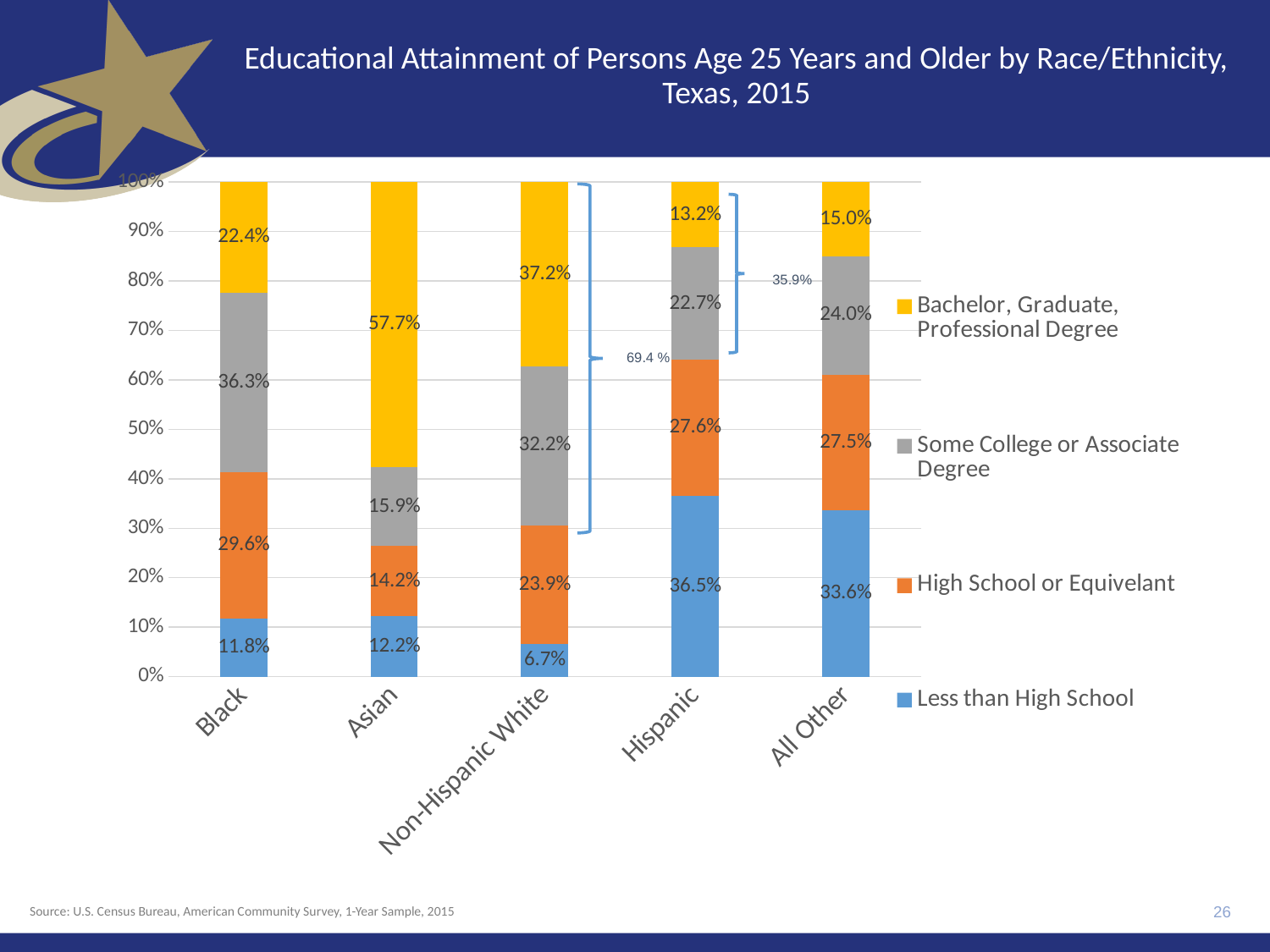
How many series does the legend list? 4 Which is larger, the Less than High School share for Hispanic or for All Other? Hispanic What is the difference between the Bachelor, Graduate, Professional Degree shares for Asian and Black? 35.3% What is the High School or Equivelant value for Hispanic? 27.6% What is the Some College or Associate Degree value for All Other? 24.0% Which race/ethnicity group has the lowest Less than High School share? Non-Hispanic White What is the Less than High School value for Non-Hispanic White? 6.7% What is the combined share of Some College or Associate Degree and Bachelor, Graduate, Professional Degree for Non-Hispanic White? 69.4% How many race/ethnicity categories are shown on the x axis? 5 What kind of chart is shown on the slide? Stacked bar chart What percentage of Black persons age 25 and older have a Bachelor, Graduate, or Professional Degree? 22.4% Which race/ethnicity group has the highest share with a Bachelor, Graduate, or Professional Degree? Asian